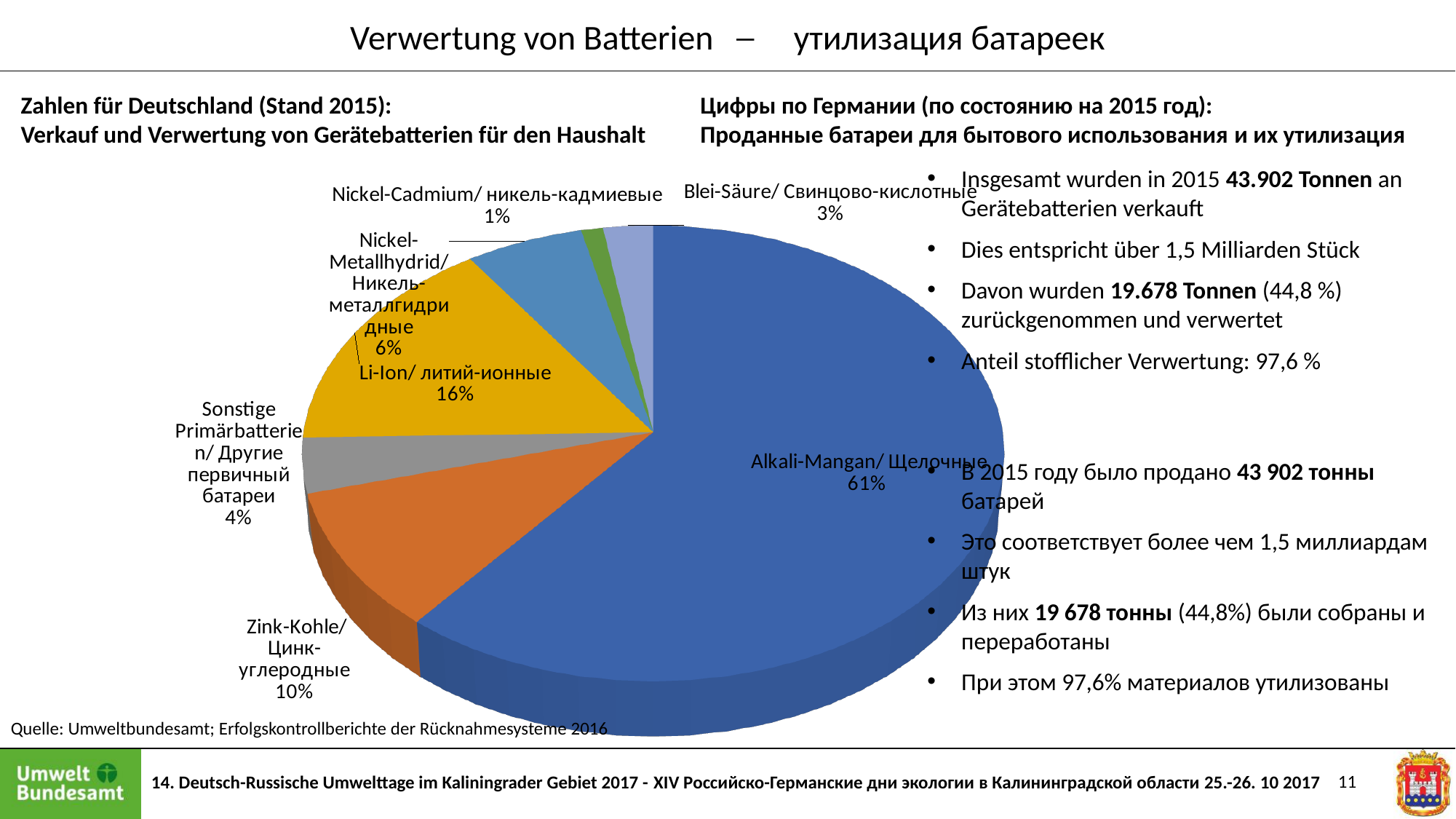
What percentage is shown for Li-Ion batteries? 16% How many slices does the pie chart have? 7 Which battery type has the largest slice of the pie? Alkali-Mangan Which slice is larger, Sonstige Primärbatterien or Nickel-Metallhydrid? Nickel-Metallhydrid Which battery type has the smallest slice of the pie? Nickel-Cadmium What colour is the Li-Ion slice of the pie? Yellow What share of the pie does the Alkali-Mangan slice represent? 61% What kind of chart is shown on the slide? Pie chart What percentage is shown for Blei-Säure batteries? 3% What is the difference in percentage points between the Li-Ion slice and the Zink-Kohle slice? 6 What percentage is shown for Zink-Kohle batteries? 10% What percentage is shown for Nickel-Metallhydrid batteries? 6%